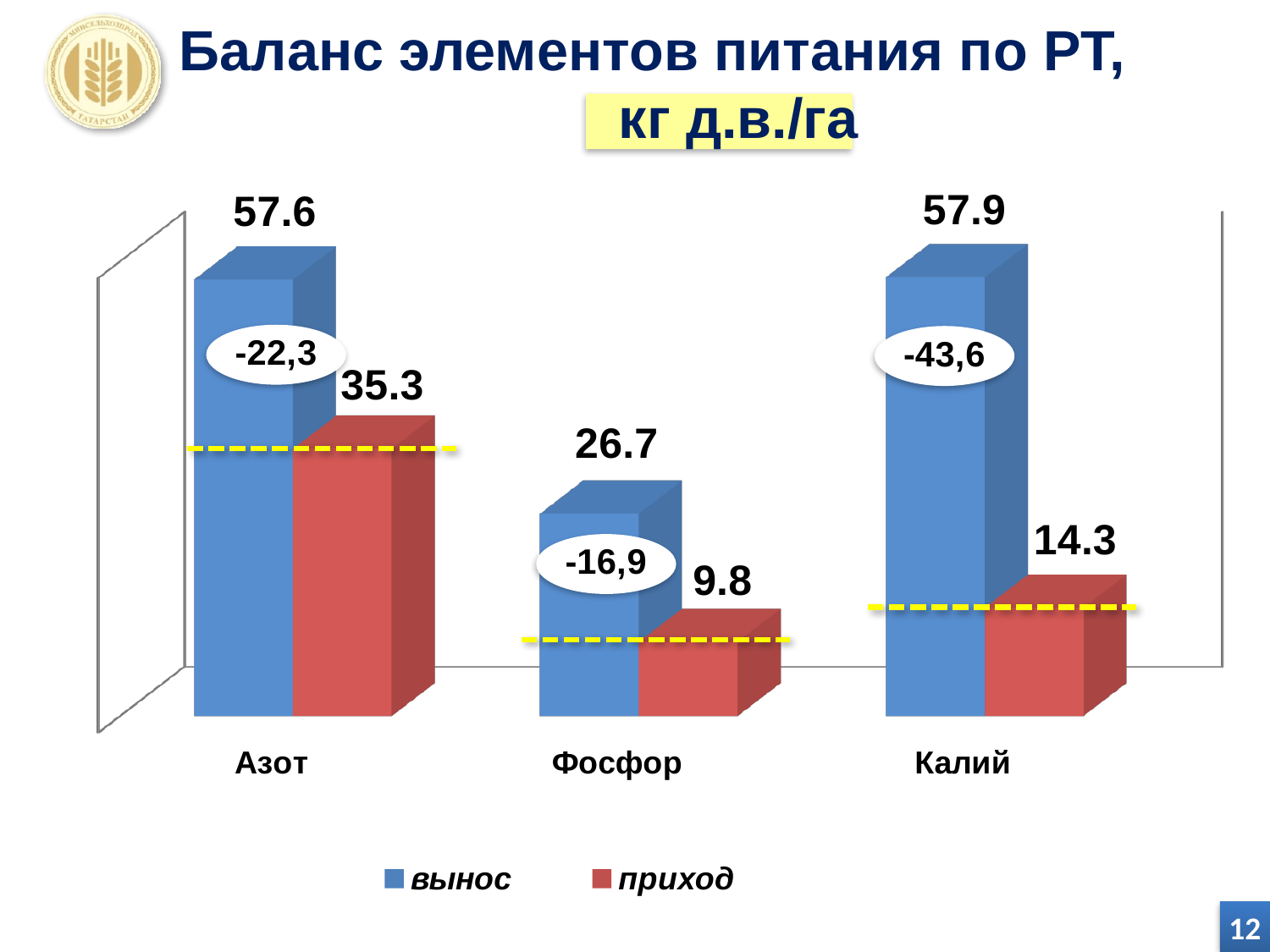
How many series does the legend list? 2 What kind of chart is shown on the slide? bar chart Which category has the highest приход value? Азот What is the value of приход for Калий? 14.3 Which category has the lowest вынос value? Фосфор Which is larger for Азот: вынос or приход? вынос What is the value of приход for Фосфор? 9.8 What is the value of вынос for Азот? 57.6 What is the difference between вынос and приход for Калий? 43.6 What is the value of вынос for Фосфор? 26.7 How many categories are shown on the x axis? 3 Which category has the lowest приход value? Фосфор